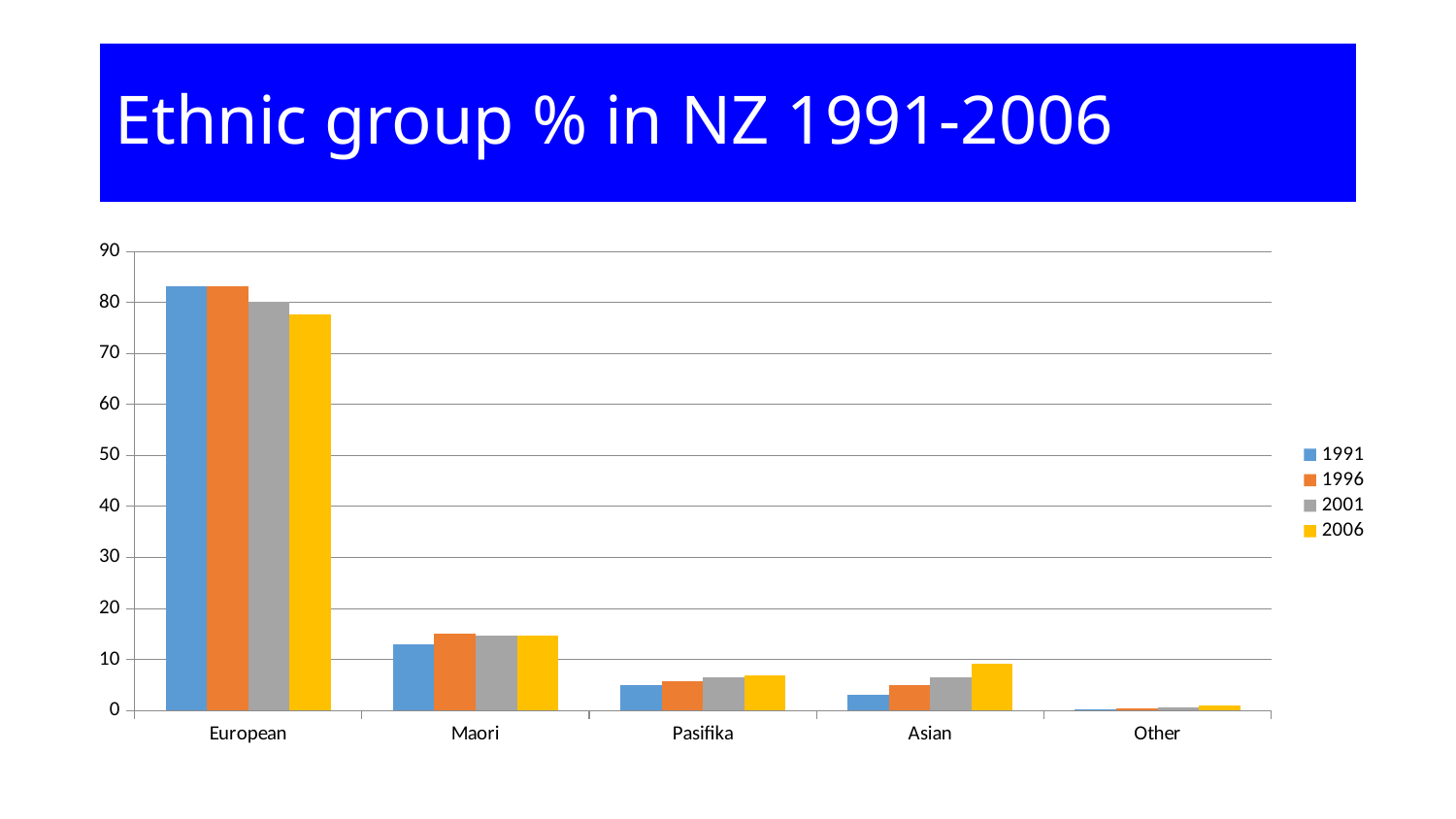
Which ethnic group has the highest values in the chart? European Which is larger for European: the 1991 value or the 2006 value? 1991 How many ethnic group categories are shown on the x axis? 5 What is the title of the slide? Ethnic group % in NZ 1991-2006 What kind of chart is shown on the slide? Bar chart Is the value for European in 2006 greater or less than 80? less Do the Asian values rise or fall from 1991 to 2006? Rise Is the value for Asian in 1991 greater or less than 10? less Is the value for European in 1991 greater or less than 80? greater Which ethnic group has the lowest values in the chart? Other How many series does the legend list? 4